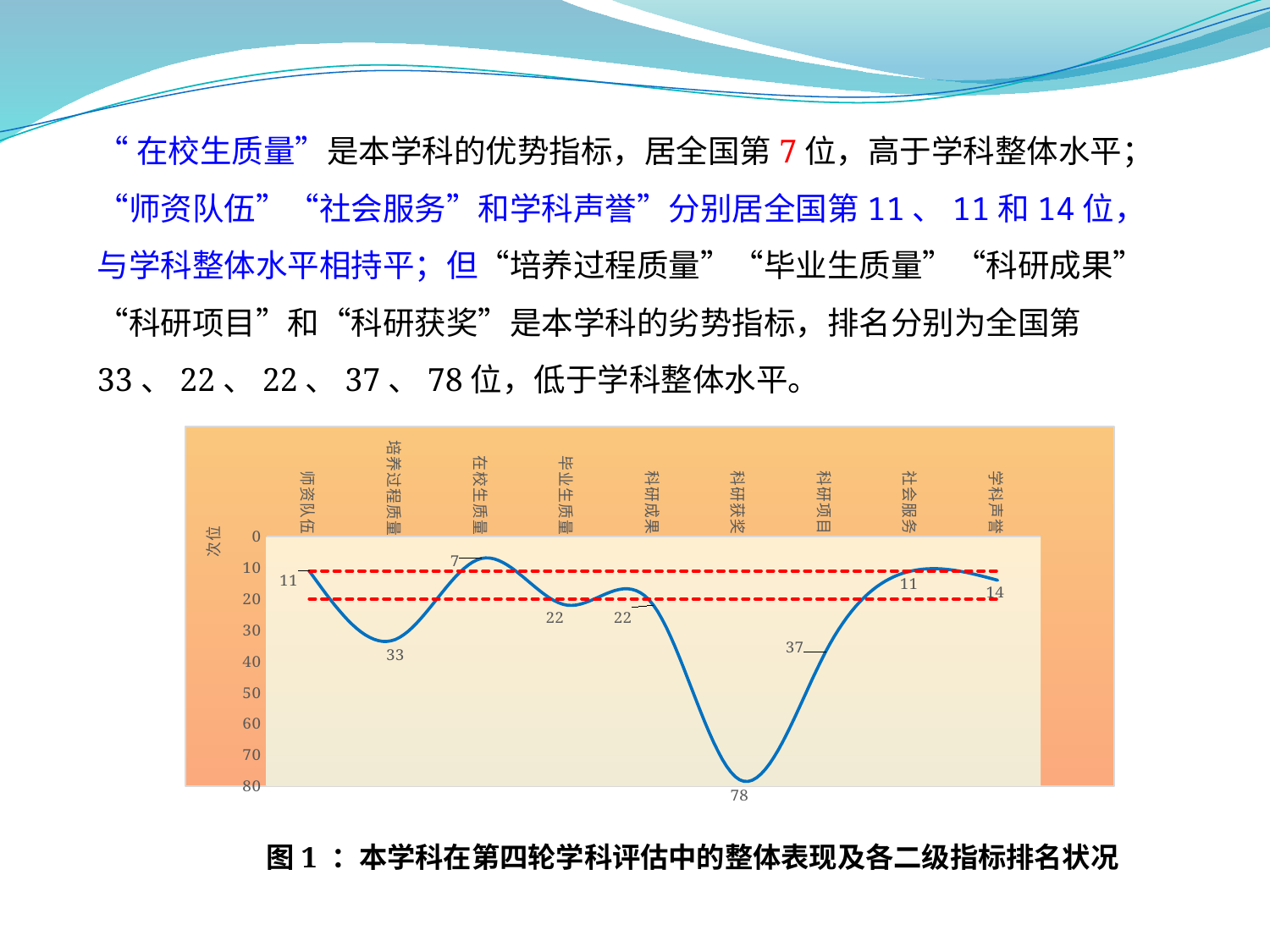
How many categories are plotted on the x axis? 9 What type of chart is shown on the slide? line chart What is the value for 科研获奖? 78 What is the difference between the values for 科研获奖 and 科研项目? 41 Which has the larger value, 培养过程质量 or 毕业生质量? 培养过程质量 What is the value for 培养过程质量? 33 What is the value for 在校生质量? 7 What is the label of the vertical axis? 次位 What is the caption of the figure below the chart? 图1：本学科在第四轮学科评估中的整体表现及各二级指标排名状况 Which category has the smallest value? 在校生质量 Which category has the largest value? 科研获奖 What is the value for 学科声誉? 14